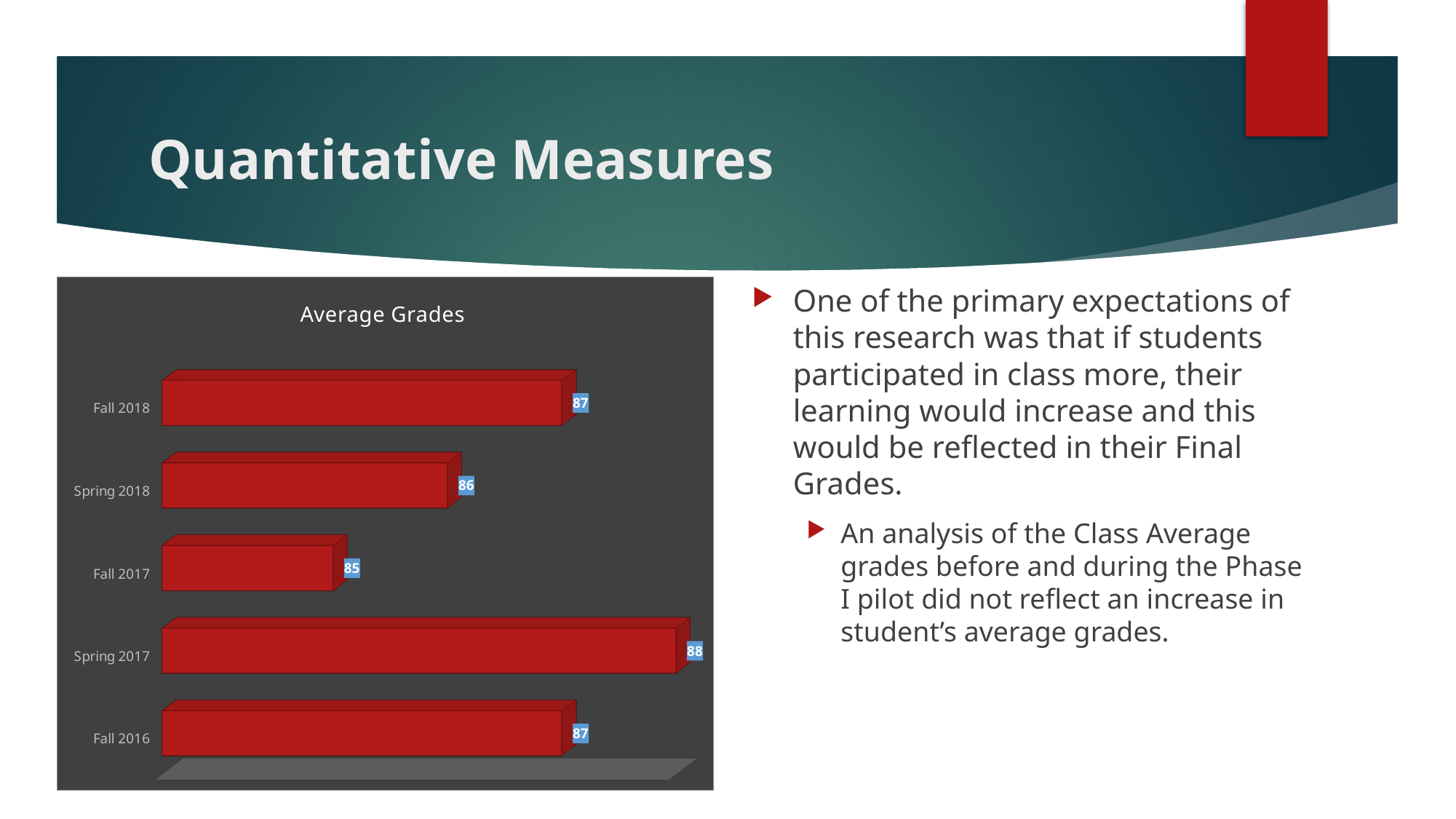
What is the average grade for Spring 2017? 88 What kind of chart is shown on the slide? Bar chart What is the title of the chart? Average Grades What is the average grade for Fall 2017? 85 What is the difference between the average grades for Spring 2017 and Fall 2017? 3 Which has a higher average grade, Spring 2018 or Fall 2018? Fall 2018 What is the average grade for Fall 2018? 87 Which semester has the highest average grade? Spring 2017 What is the average grade for Spring 2018? 86 Which semester has the lowest average grade? Fall 2017 What is the difference between the average grades for Fall 2016 and Spring 2018? 1 How many semesters are shown in the chart? 5